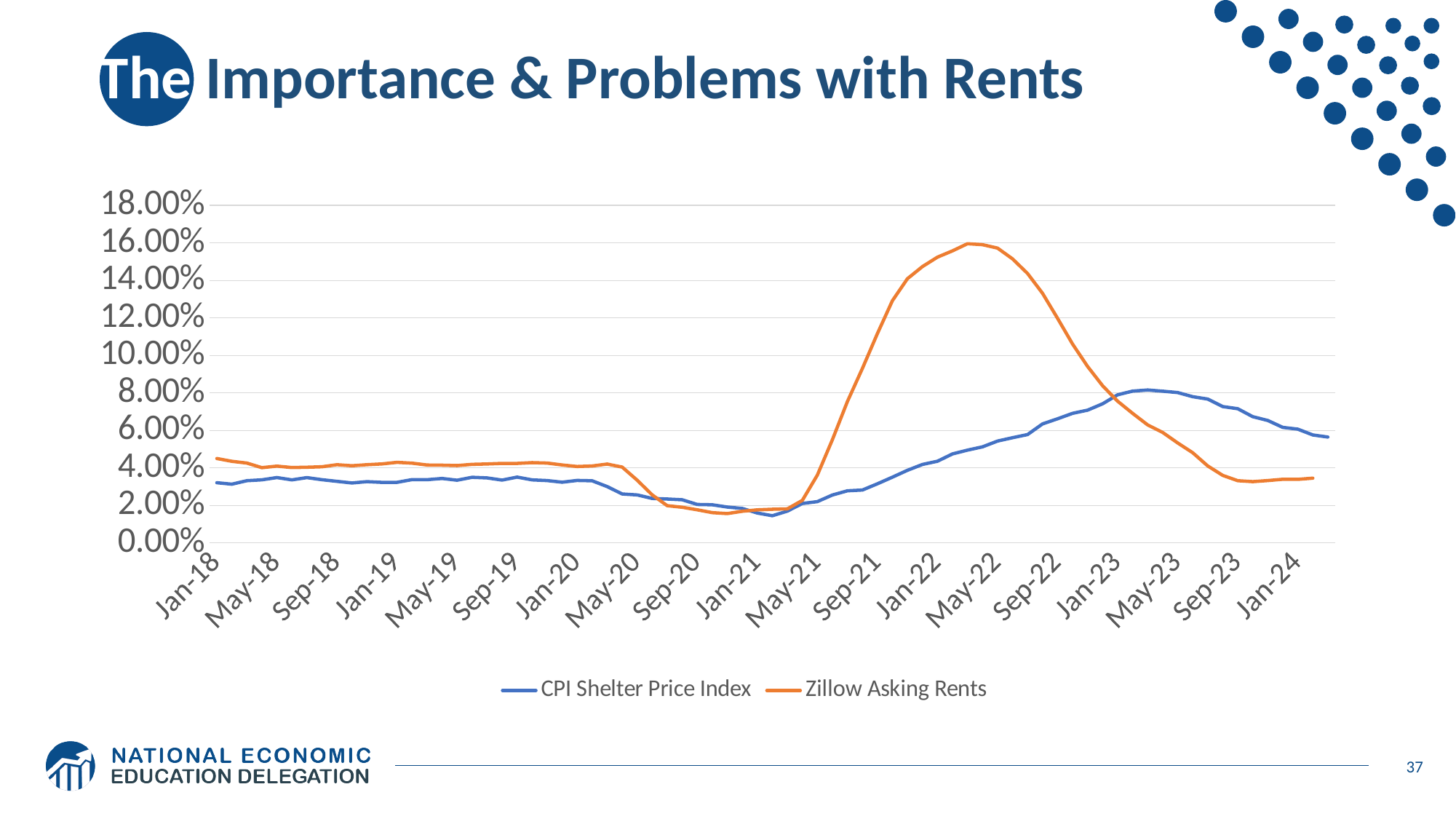
How many series does the legend list? 2 Which series reaches the higher peak value on the chart? Zillow Asking Rents Is the value for CPI Shelter Price Index at May-23 greater or less than 6.00%? greater Is the value for Zillow Asking Rents at May-22 greater or less than 14.00%? greater What kind of chart is shown on the slide? Line chart At May-23, which series has the larger value, CPI Shelter Price Index or Zillow Asking Rents? CPI Shelter Price Index What colour is the line for Zillow Asking Rents? Orange At Jan-22, which series has the larger value, CPI Shelter Price Index or Zillow Asking Rents? Zillow Asking Rents Does the Zillow Asking Rents line rise or fall between May-22 and Sep-23? Fall Which two series are listed in the legend? CPI Shelter Price Index and Zillow Asking Rents Is the value for Zillow Asking Rents at Jan-21 greater or less than 2.00%? less